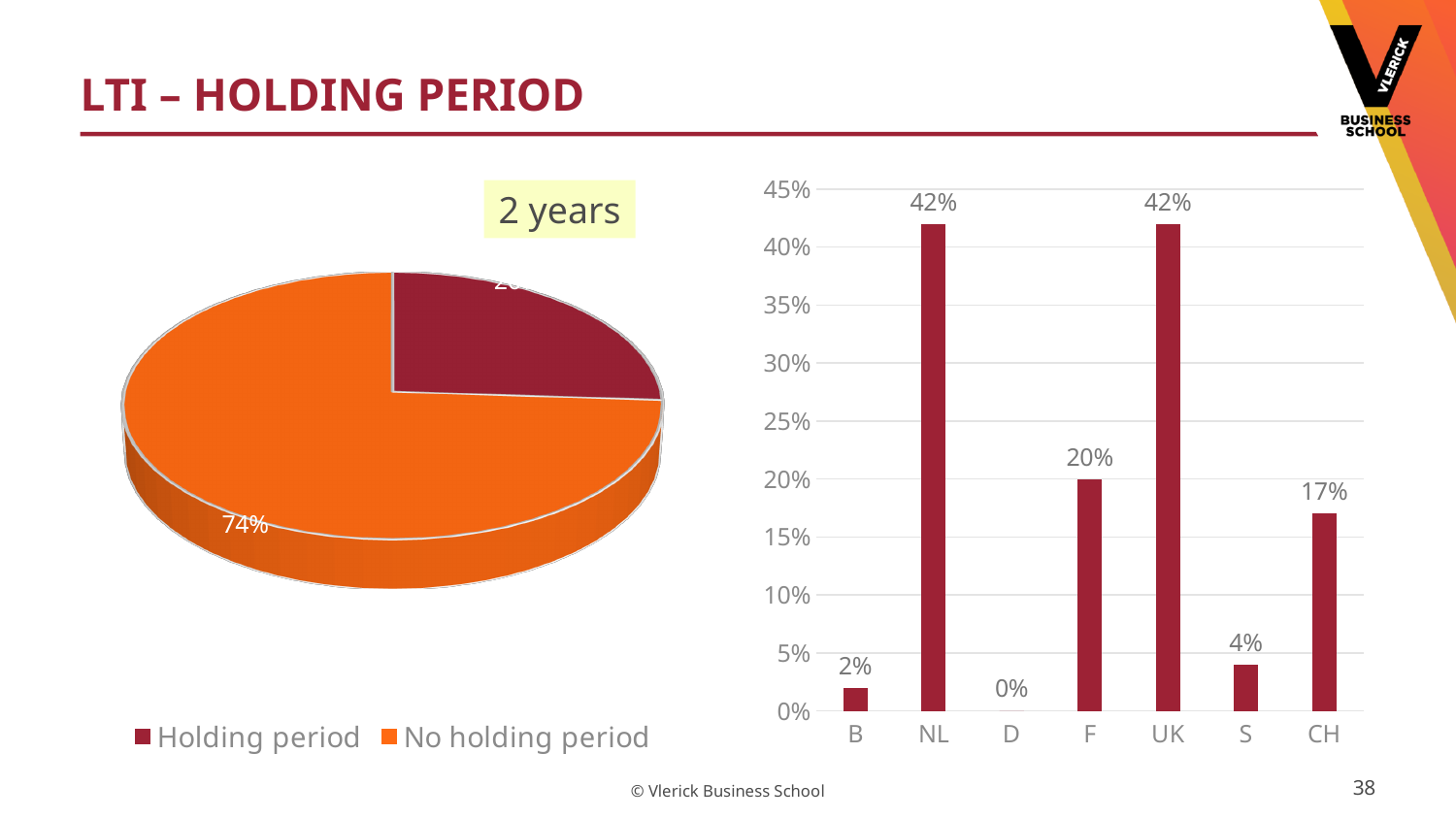
In the bar chart on the right, which category has the lowest value? D How many entries does the legend of the pie chart on the left list? 2 In the bar chart on the right, what is the value for CH? 17% In the pie chart on the left, what share does the No holding period slice have? 74% What kind of chart is on the left side of the slide? Pie chart In the bar chart on the right, what is the value for B? 2% In the bar chart on the right, what is the value for NL? 42% In the bar chart on the right, how many categories are shown on the x axis? 7 In the bar chart on the right, what is the difference between the values for UK and S? 38% In the bar chart on the right, what is the value for F? 20% What kind of chart is on the right side of the slide? Bar chart In the bar chart on the right, which is larger, the value for F or the value for CH? F